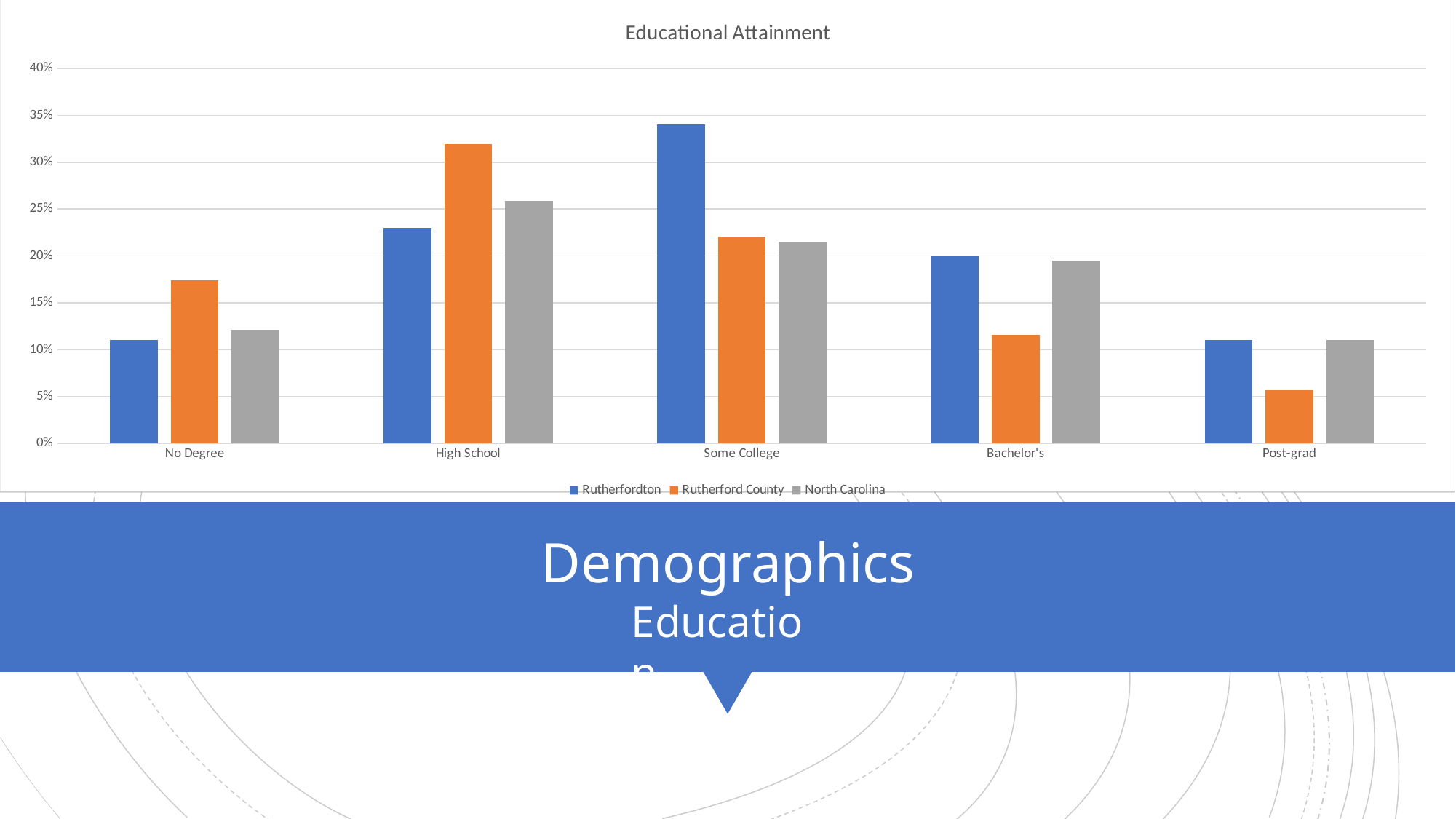
How many education categories are shown on the x axis? 5 Which category has the highest bar for Rutherfordton? Some College Which category has the highest bar for Rutherford County? High School What kind of chart is shown on the slide? bar chart In the No Degree category, which is larger: Rutherfordton or Rutherford County? Rutherford County Is the value for Rutherford County in the Post-grad category greater or less than 10%? less Is the value for Rutherford County in the High School category greater or less than 30%? greater How many series does the legend list? 3 Is the value for Rutherfordton in the Some College category greater or less than 30%? greater Which category has the lowest bar for Rutherford County? Post-grad In the Bachelor's category, which is larger: Rutherfordton or Rutherford County? Rutherfordton What is the title of the chart? Educational Attainment